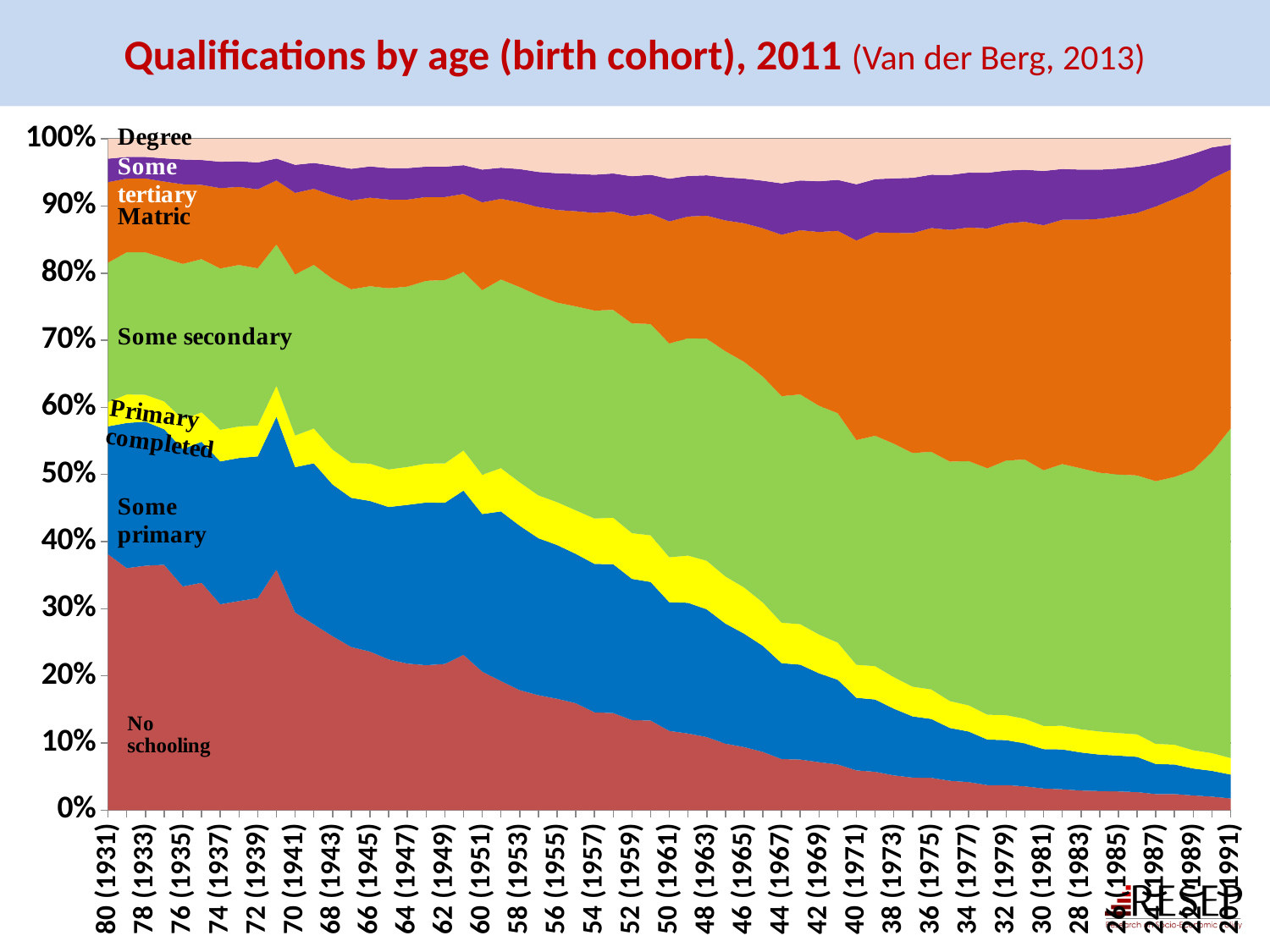
How many qualification categories (series) are labelled on the chart? 7 Does the share of 'No schooling' rise or fall as you move from age 80 (1931) to age 20 (1991) along the x axis? Fall Is the 'No schooling' share for age 20 (1991) greater or less than 10%? less How many age (birth cohort) labels are shown along the x axis? 31 Which qualification category has the largest share for age 20 (1991)? Some secondary Which is larger for age 20 (1991): the 'Some secondary' share or the 'No schooling' share? Some secondary Which is larger for age 80 (1931): the 'No schooling' share or the 'Matric' share? No schooling Does the share of 'Matric' rise or fall as you move from age 80 (1931) to age 20 (1991) along the x axis? Rise What kind of chart is shown on the slide? Stacked area chart Which qualification category forms the bottom band of the chart? No schooling Is the 'No schooling' share for age 80 (1931) greater or less than 30%? greater What is the title of the chart on the slide? Qualifications by age (birth cohort), 2011